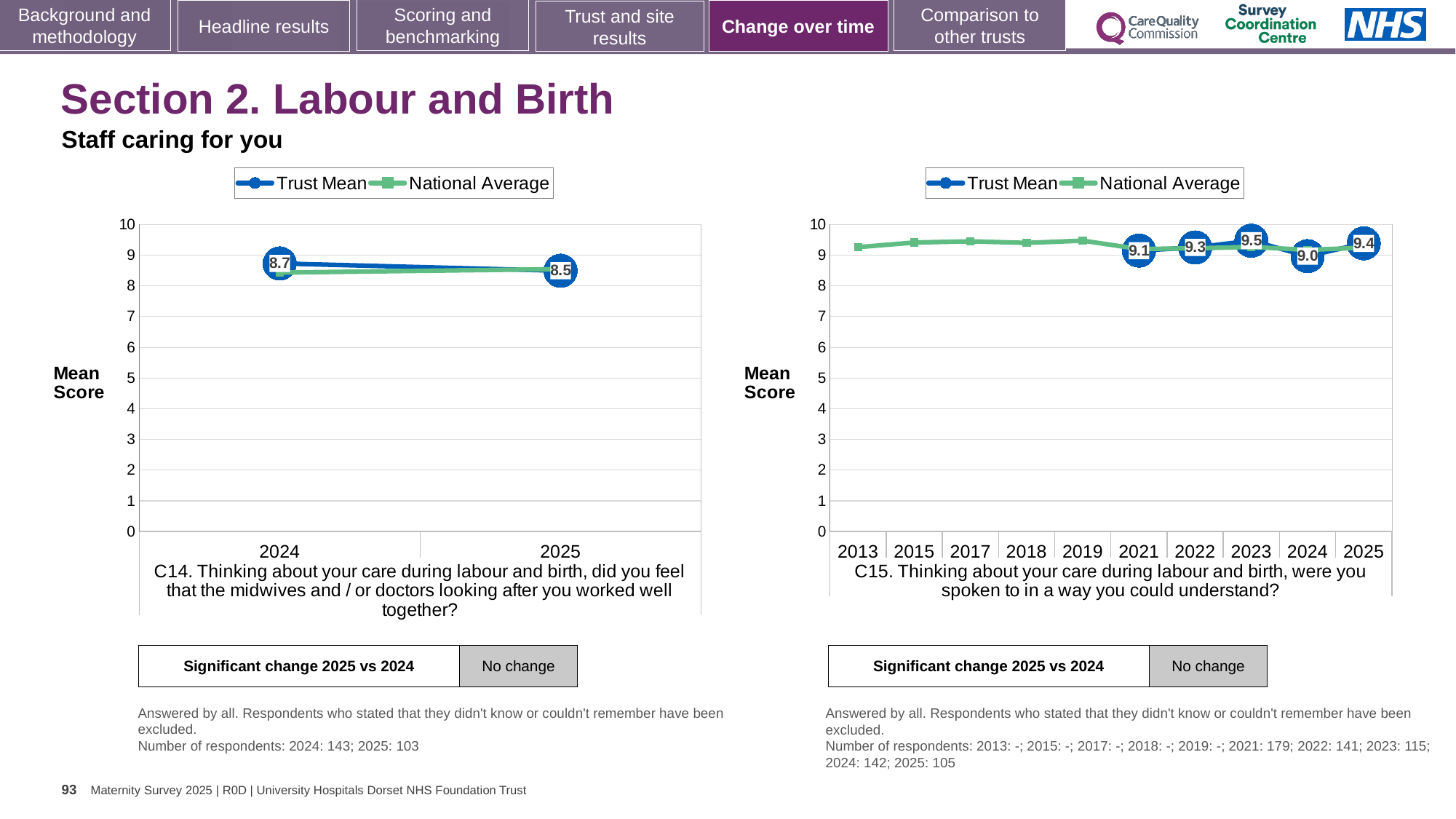
In the C15 chart on the right, which year has the highest Trust Mean score? 2023 How many series does the legend of the C14 chart on the left list? 2 In the C14 chart on the left, what is the Trust Mean score for 2024? 8.7 In the C15 chart on the right, how many years are shown on the x axis? 10 What type of chart is the C15 chart on the right? line chart In the C15 chart on the right, what is the Trust Mean score for 2023? 9.5 In the C15 chart on the right, which year has the lowest labelled Trust Mean score? 2024 In the C15 chart on the right, what is the difference between the Trust Mean scores for 2023 and 2024? 0.5 In the C14 chart on the left, by how much did the Trust Mean change from 2024 to 2025? 0.2 In the C14 chart on the left, does the Trust Mean rise or fall from 2024 to 2025? fall In the C15 chart on the right, what is the Trust Mean score for 2024? 9.0 In the C14 chart on the left, what is the Trust Mean score for 2025? 8.5